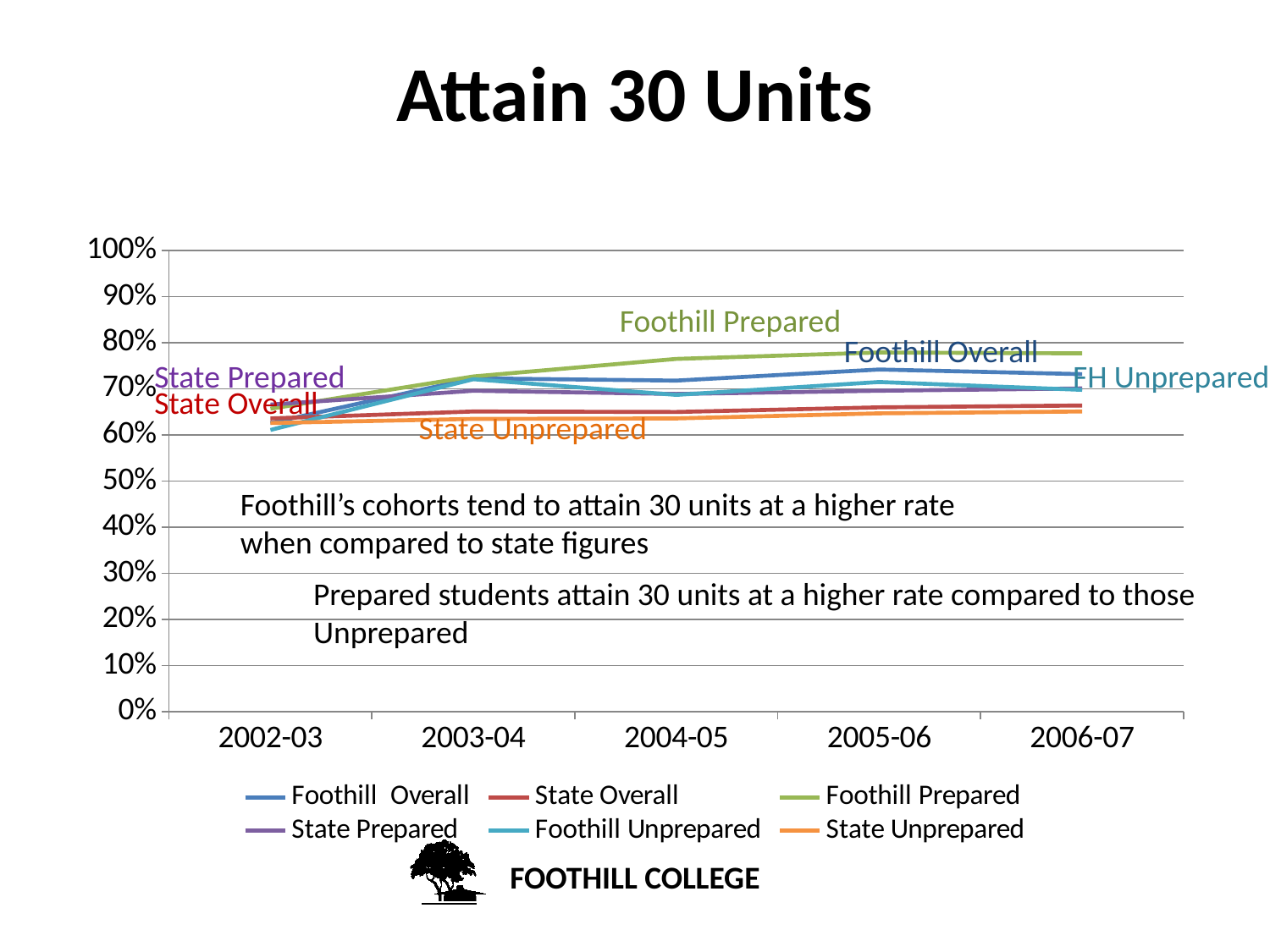
Which series has the highest value in 2006-07? Foothill Prepared Is the value for Foothill Overall in 2005-06 greater or less than 70%? greater Is the value for State Overall in 2004-05 greater or less than 70%? less What kind of chart is shown on the slide? line chart How many series does the legend list? 6 How many academic years are shown on the x axis? 5 Is the value for Foothill Prepared in 2006-07 greater or less than 70%? greater What is the title of the chart? Attain 30 Units In 2005-06, which is larger: Foothill Prepared or State Unprepared? Foothill Prepared Does the Foothill Prepared line rise or fall from 2002-03 to 2006-07? rise Which colour is used for the Foothill Prepared line? green